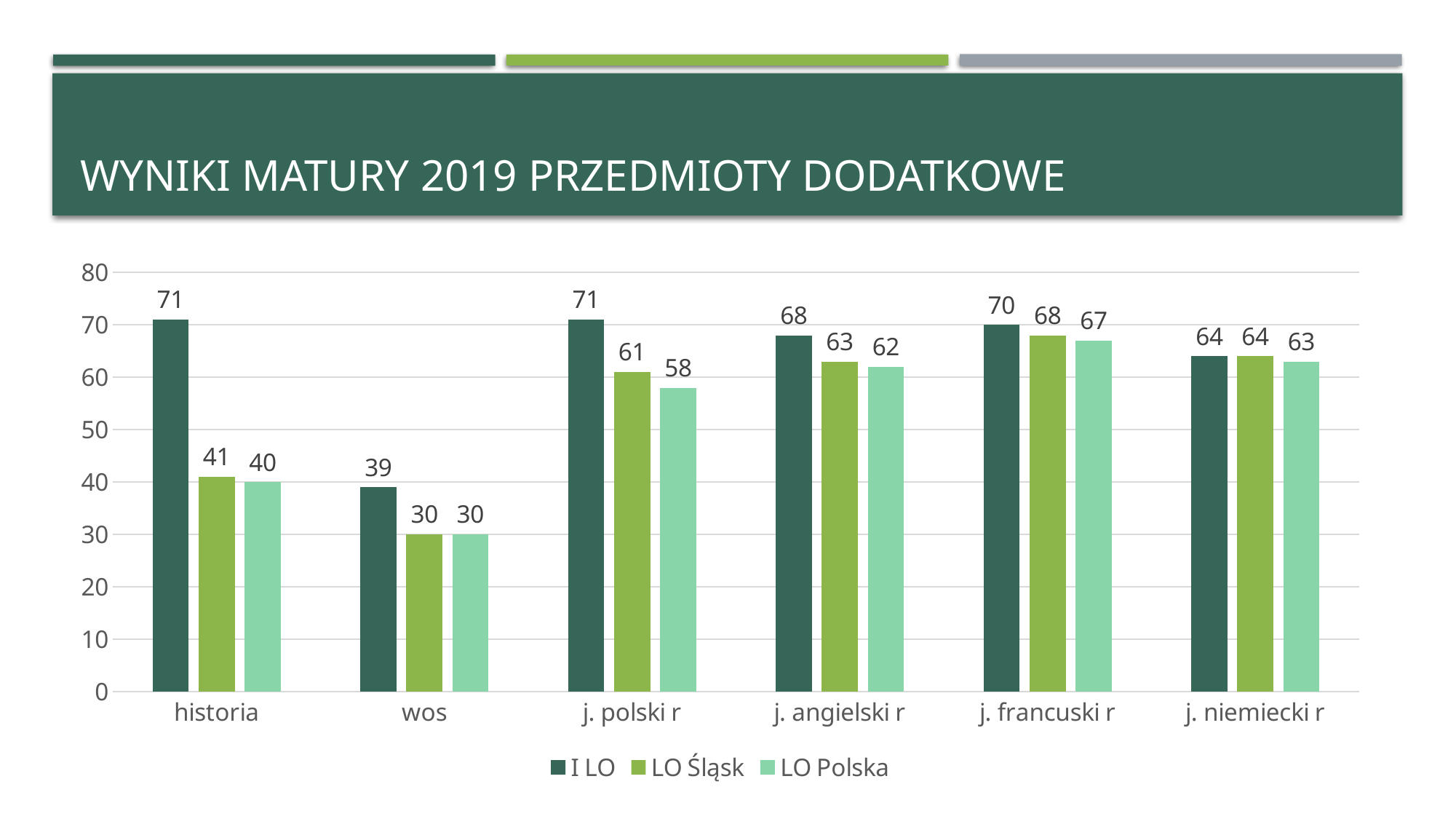
Which is larger in j. angielski r: LO Śląsk or LO Polska? LO Śląsk What is the value for LO Polska in j. polski r? 58 What kind of chart is shown on the slide? bar chart What is the value for LO Śląsk in j. francuski r? 68 Which category has the lowest value for I LO? wos How many categories are shown on the x axis? 6 What is the value for I LO in historia? 71 Which category has the highest value for LO Śląsk? j. francuski r How many series does the legend list? 3 What is the title of the slide? WYNIKI MATURY 2019 PRZEDMIOTY DODATKOWE What is the difference between I LO and LO Polska in j. polski r? 13 What is the difference between I LO and LO Śląsk in wos? 9